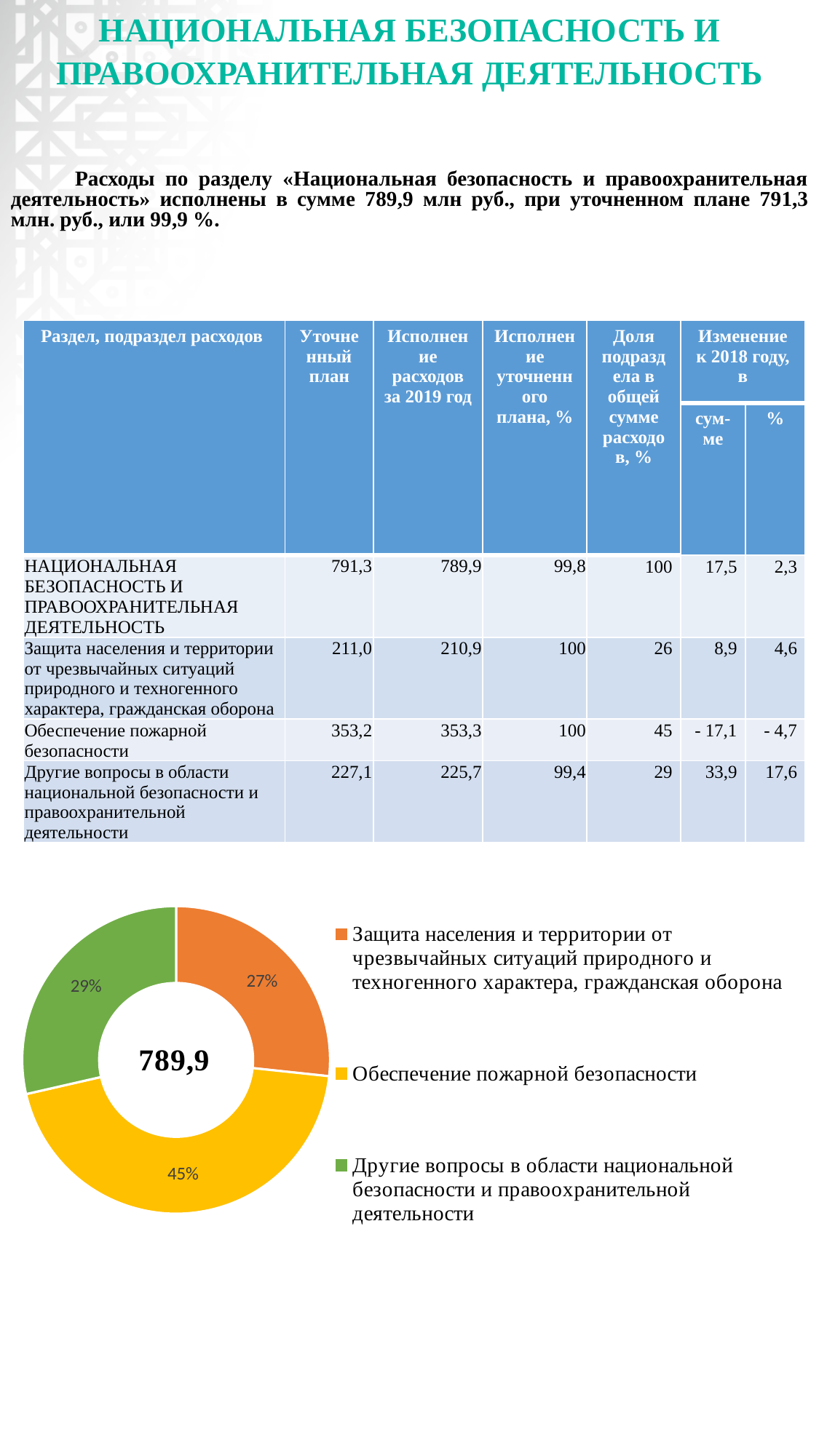
What is the difference in percentage points between the "Обеспечение пожарной безопасности" slice and the "Другие вопросы в области национальной безопасности и правоохранительной деятельности" slice? 16 percentage points Which slice of the doughnut chart is the largest? Обеспечение пожарной безопасности What share of the doughnut chart does "Другие вопросы в области национальной безопасности и правоохранительной деятельности" take? 29% What number is printed in the centre of the doughnut chart? 789,9 How many slices does the doughnut chart have? 3 How many entries does the legend of the doughnut chart list? 3 What colour is the "Обеспечение пожарной безопасности" slice in the doughnut chart? Yellow What kind of chart is shown at the bottom of the slide? Doughnut (pie) chart Which slice of the doughnut chart is the smallest? Защита населения и территории от чрезвычайных ситуаций природного и техногенного характера, гражданская оборона What share of the doughnut chart does "Обеспечение пожарной безопасности" take? 45% Which is larger in the doughnut chart: the share for "Другие вопросы в области национальной безопасности и правоохранительной деятельности" or the share for "Защита населения и территории от чрезвычайных ситуаций природного и техногенного характера, гражданская оборона"? Другие вопросы в области национальной безопасности и правоохранительной деятельности What share of the doughnut chart does "Защита населения и территории от чрезвычайных ситуаций природного и техногенного характера, гражданская оборона" take? 27%